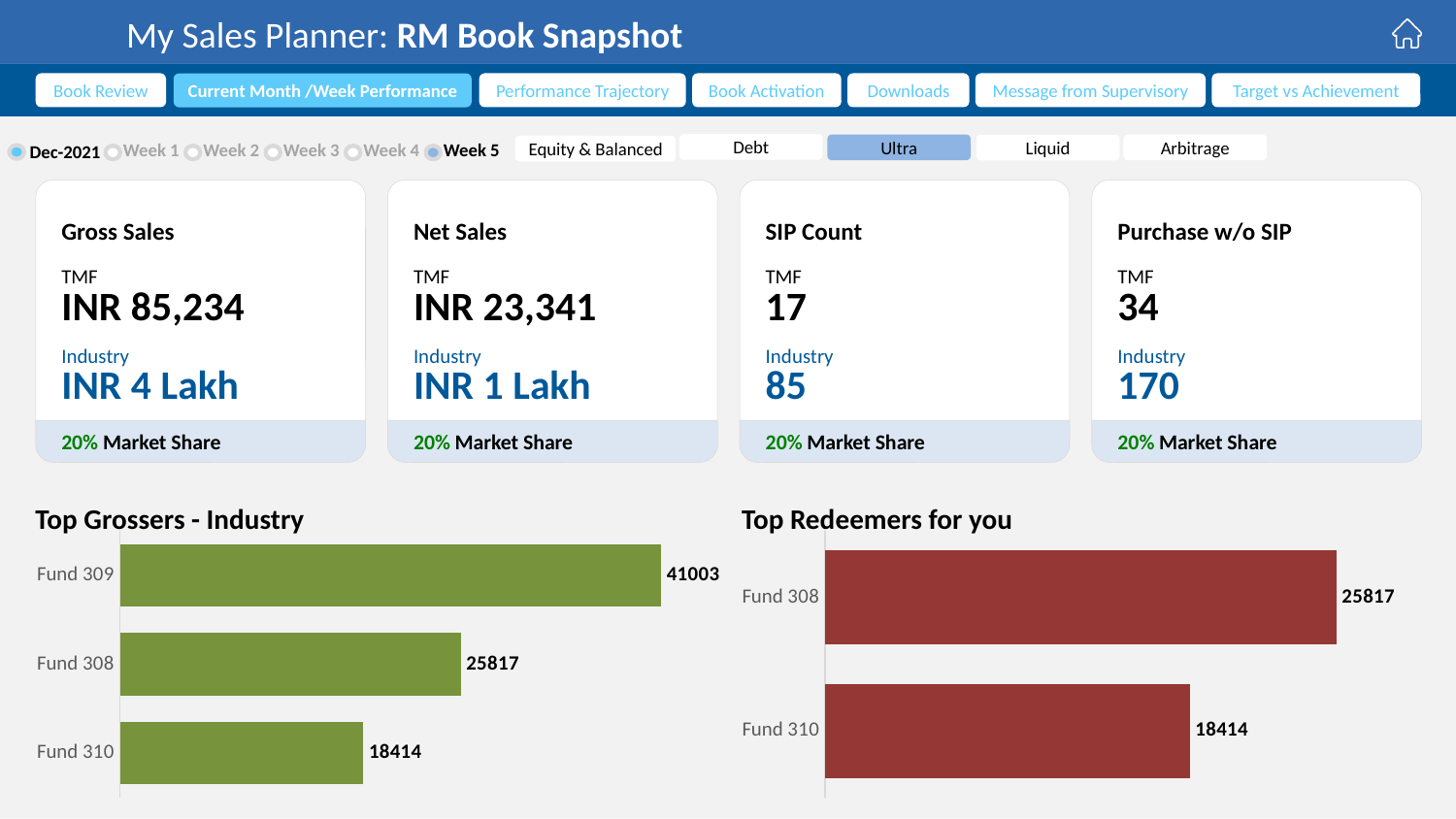
In the Top Grossers - Industry chart, which is larger: Fund 308 or Fund 310? Fund 308 How many funds are shown in the Top Grossers - Industry chart? 3 What type of chart is the Top Redeemers for you chart? Bar chart In the Top Grossers - Industry chart, which fund has the lowest value? Fund 310 In the Top Redeemers for you chart, what is the value for Fund 308? 25817 In the Top Grossers - Industry chart, what is the value for Fund 310? 18414 In the Top Grossers - Industry chart, what is the difference between Fund 309 and Fund 308? 15186 In the Top Redeemers for you chart, which fund has the lower value? Fund 310 How many funds are shown in the Top Redeemers for you chart? 2 In the Top Redeemers for you chart, what is the difference between Fund 308 and Fund 310? 7403 In the Top Grossers - Industry chart, which fund has the highest value? Fund 309 In the Top Grossers - Industry chart, what is the value for Fund 309? 41003